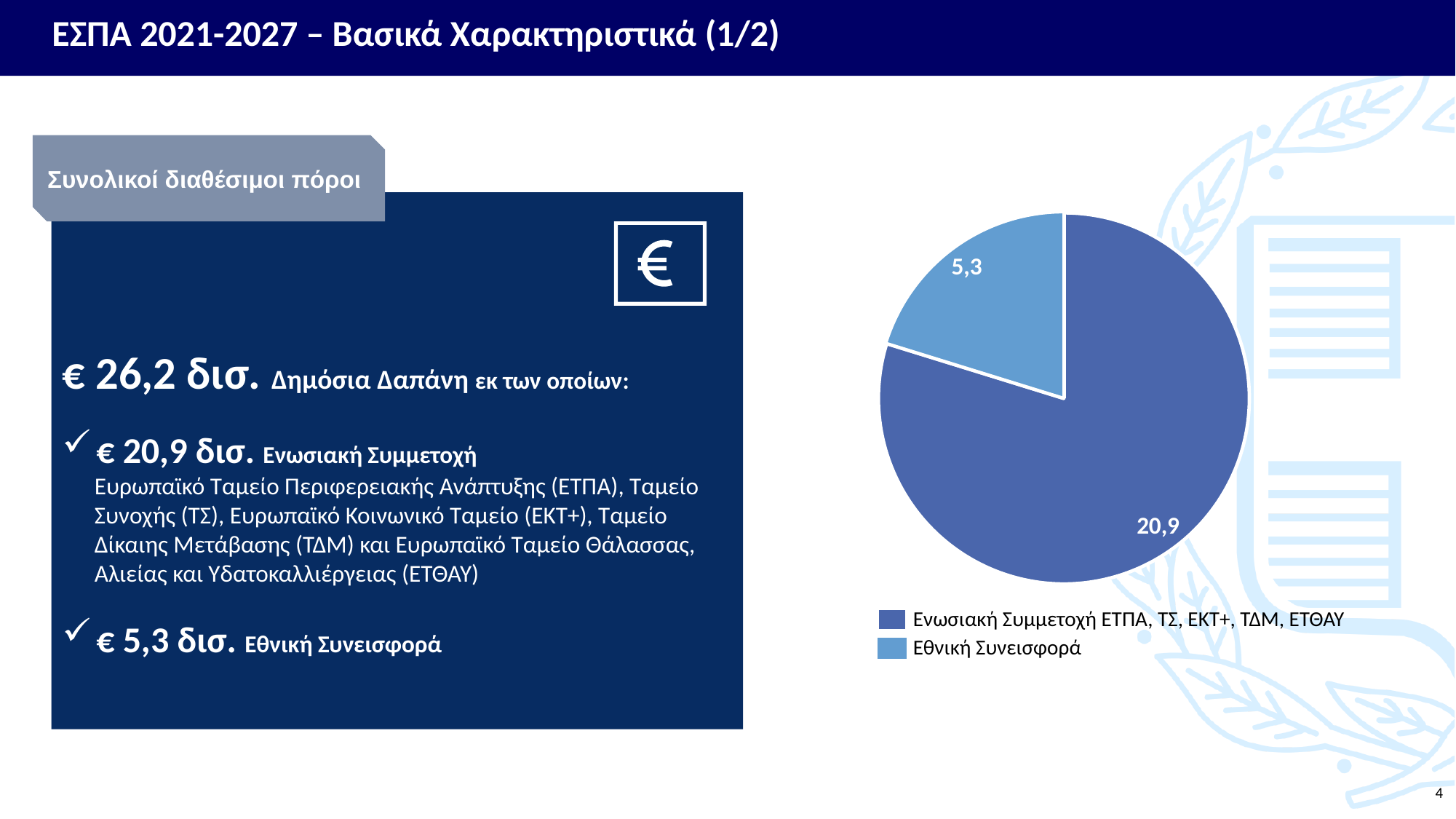
Which is larger in the pie chart: Εθνική Συνεισφορά or Ενωσιακή Συμμετοχή? Ενωσιακή Συμμετοχή How many entries does the legend of the pie chart list? 2 Which colour represents Εθνική Συνεισφορά in the pie chart? light blue What is the value of the Εθνική Συνεισφορά slice in the pie chart? 5,3 How many slices does the pie chart have? 2 What is the difference between the Ενωσιακή Συμμετοχή slice and the Εθνική Συνεισφορά slice in the pie chart? 15,6 Which legend entry is shown in dark blue in the pie chart? Ενωσιακή Συμμετοχή ΕΤΠΑ, ΤΣ, ΕΚΤ+, ΤΔΜ, ΕΤΘΑΥ Which slice of the pie chart is the smallest? Εθνική Συνεισφορά What kind of chart is shown on the slide? pie chart What is the value of the Ενωσιακή Συμμετοχή ΕΤΠΑ, ΤΣ, ΕΚΤ+, ΤΔΜ, ΕΤΘΑΥ slice in the pie chart? 20,9 What is the total of the two slices in the pie chart? 26,2 Which slice of the pie chart is the largest? Ενωσιακή Συμμετοχή ΕΤΠΑ, ΤΣ, ΕΚΤ+, ΤΔΜ, ΕΤΘΑΥ